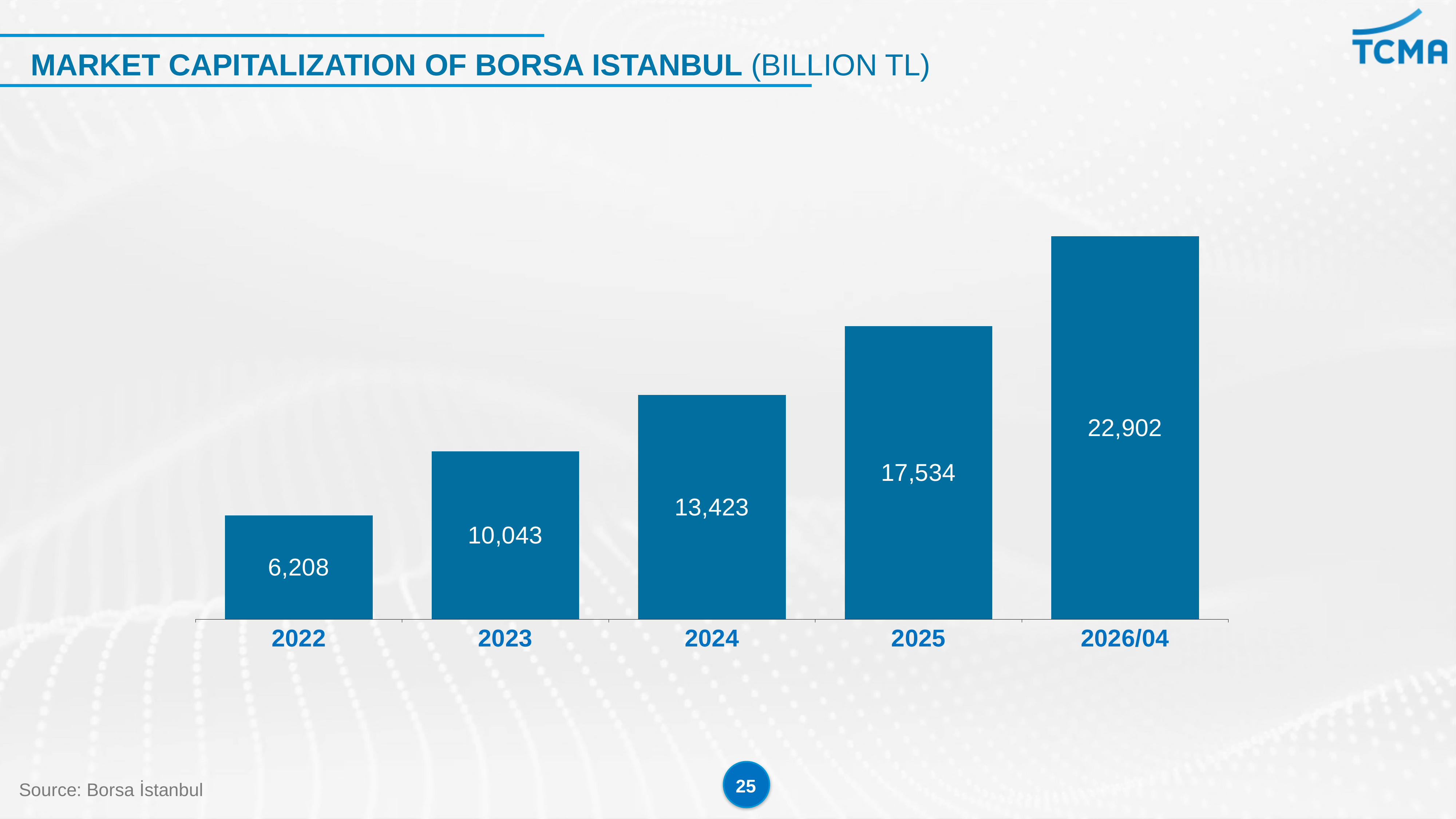
What is the market capitalization of Borsa Istanbul for 2022? 6,208 In what unit are the values on the chart expressed? Billion TL Which year has the highest market capitalization? 2026/04 What is the difference between the market capitalization in 2023 and in 2022? 3,835 Which is larger, the market capitalization in 2023 or in 2025? 2025 What is the market capitalization of Borsa Istanbul for 2024? 13,423 How many years are shown on the chart? 5 Which year has the lowest market capitalization? 2022 What kind of chart is shown on the slide? Bar chart What is the market capitalization of Borsa Istanbul for 2026/04? 22,902 Do the values rise or fall from 2022 to 2026/04? Rise What is the difference between the market capitalization in 2025 and in 2024? 4,111